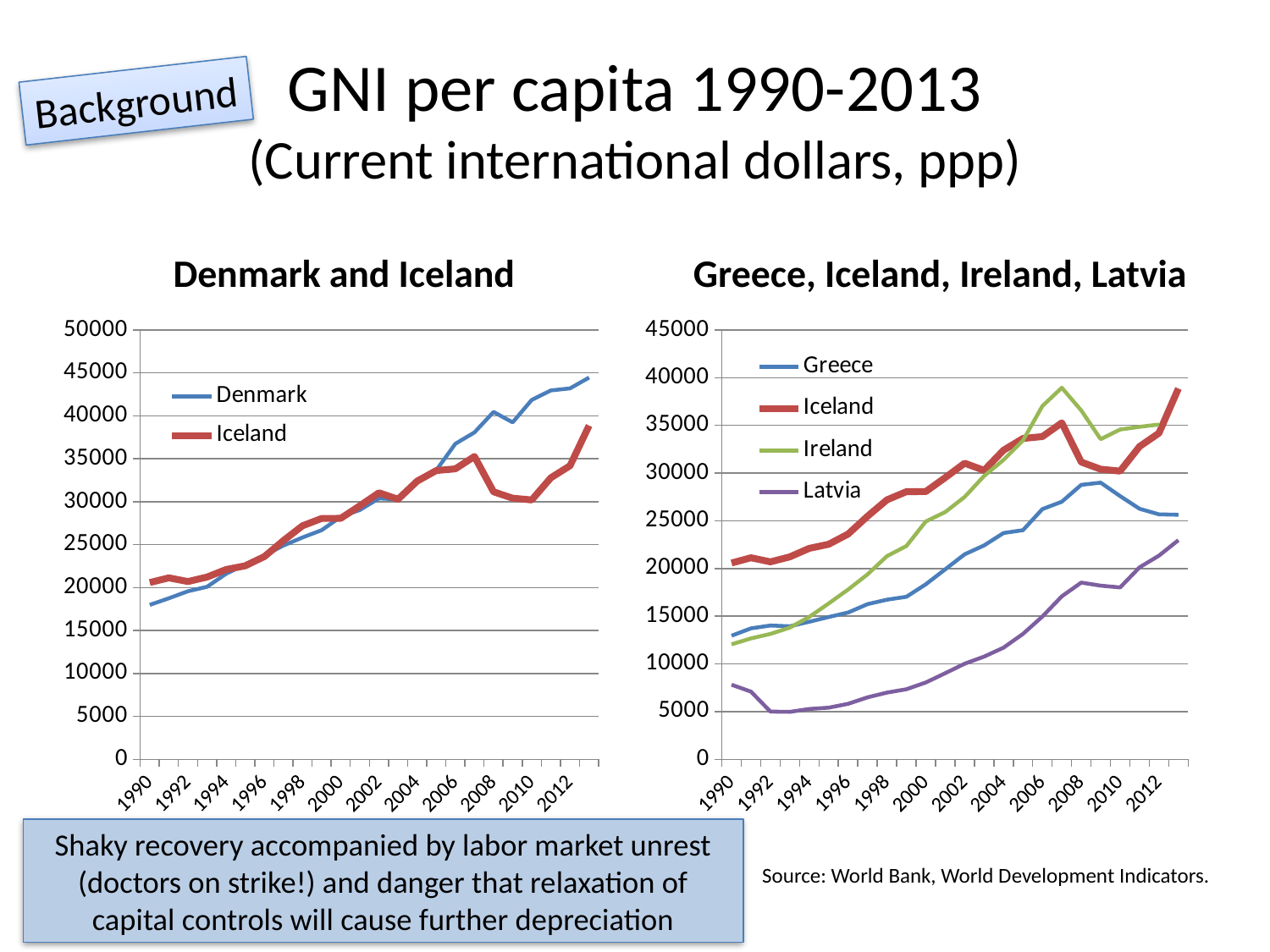
In the 'Denmark and Iceland' chart, does the Denmark line overall rise or fall from 1990 to 2013? rise In the 'Greece, Iceland, Ireland, Latvia' chart, which series has the highest value in 2007? Ireland In the 'Denmark and Iceland' chart, is the value for Iceland in 2010 greater or less than 35000? less In the 'Greece, Iceland, Ireland, Latvia' chart, is the value for Greece in 2013 greater or less than 30000? less How many series does the legend of the 'Greece, Iceland, Ireland, Latvia' chart list? 4 In the 'Greece, Iceland, Ireland, Latvia' chart, is the value for Latvia in 1990 greater or less than 10000? less In the 'Greece, Iceland, Ireland, Latvia' chart, which series has the lowest value in 2013? Latvia What kind of chart is the 'Denmark and Iceland' chart? line chart In the 'Greece, Iceland, Ireland, Latvia' chart, which series has the higher value in 1990, Iceland or Greece? Iceland How many series does the legend of the 'Denmark and Iceland' chart list? 2 In the 'Denmark and Iceland' chart, which series has the higher value in 2013, Denmark or Iceland? Denmark